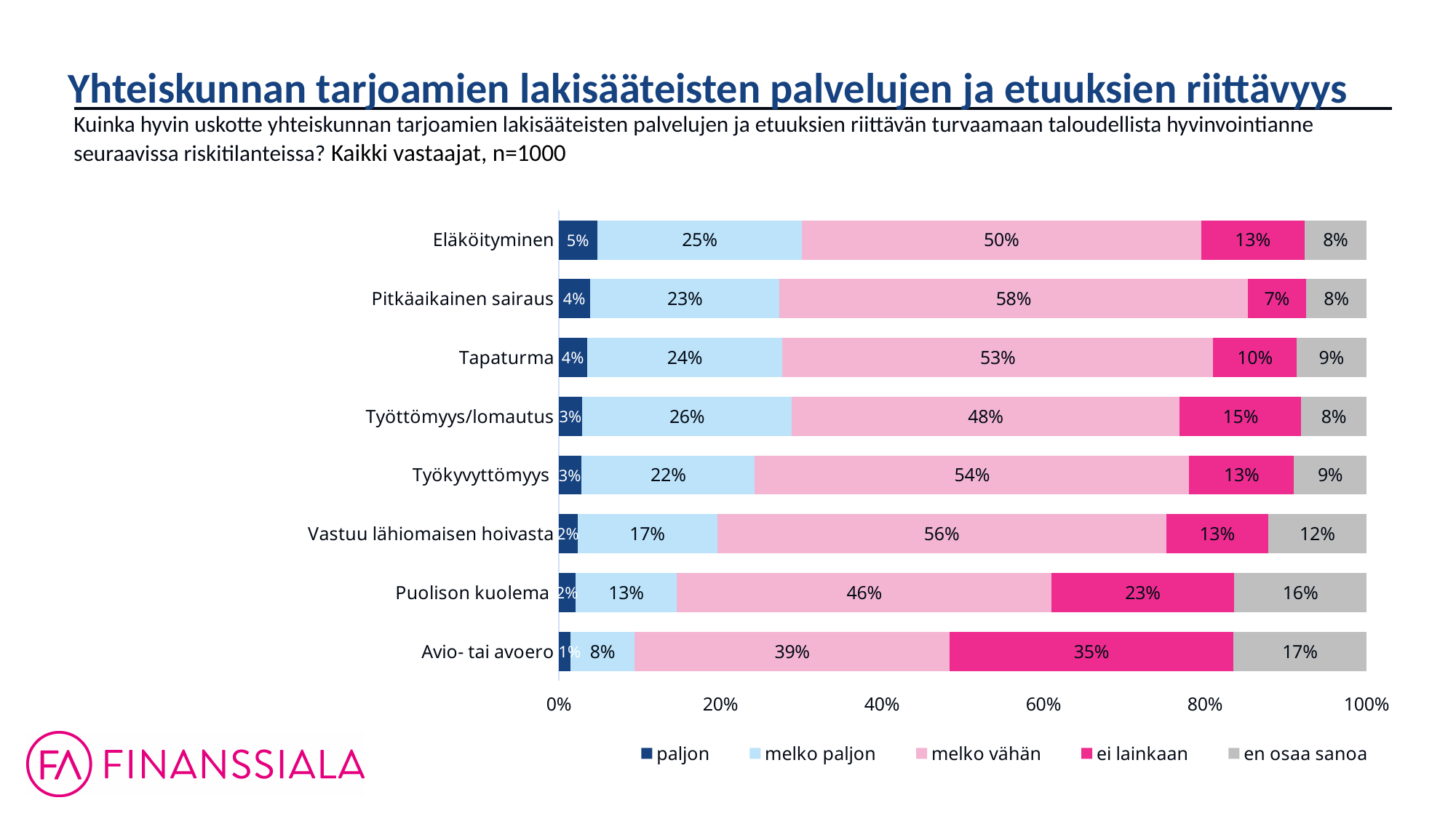
What is the "ei lainkaan" value for Avio- tai avoero? 35% What kind of chart is shown on the slide? Stacked bar chart Which category has the highest "ei lainkaan" value? Avio- tai avoero What is the "melko vähän" value for Pitkäaikainen sairaus? 58% Which category has the lowest "melko paljon" value? Avio- tai avoero How many series does the legend list? 5 What is the difference between the "melko vähän" values for Pitkäaikainen sairaus and Avio- tai avoero? 19% What is the "en osaa sanoa" value for Puolison kuolema? 16% How many categories are shown on the chart? 8 Which legend entry is shown in dark blue? paljon What is the combined "paljon" and "melko paljon" value for Eläköityminen? 30% Which is larger: the "ei lainkaan" value for Puolison kuolema or for Työttömyys/lomautus? Puolison kuolema